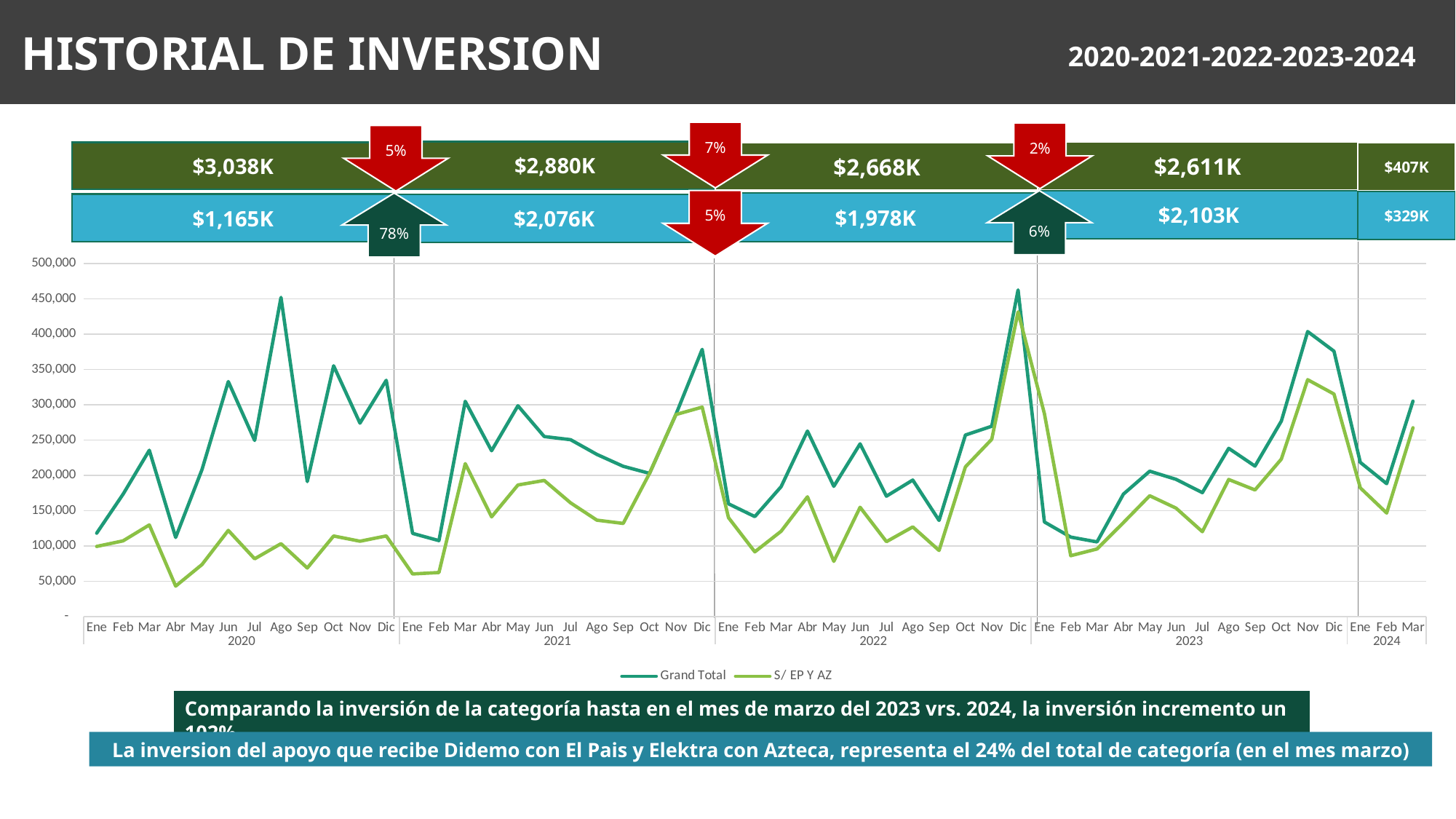
How many years are labelled along the x axis of the chart? 5 Which is larger for the Grand Total series: Dic 2022 or Ene 2023? Dic 2022 What kind of chart is shown on the slide? line chart How many series does the chart legend list? 2 In which month does the S/ EP Y AZ series reach its highest value? Dic 2022 Does the Grand Total series rise or fall from Dic 2022 to Feb 2023? fall Is the S/ EP Y AZ value for Abr 2020 greater or less than 50,000? less Is the S/ EP Y AZ value for Ene 2021 greater or less than 100,000? less Is the Grand Total value for Nov 2023 greater or less than 350,000? greater What are the two series named in the chart legend? Grand Total and S/ EP Y AZ In which month does the S/ EP Y AZ series reach its lowest value? Abr 2020